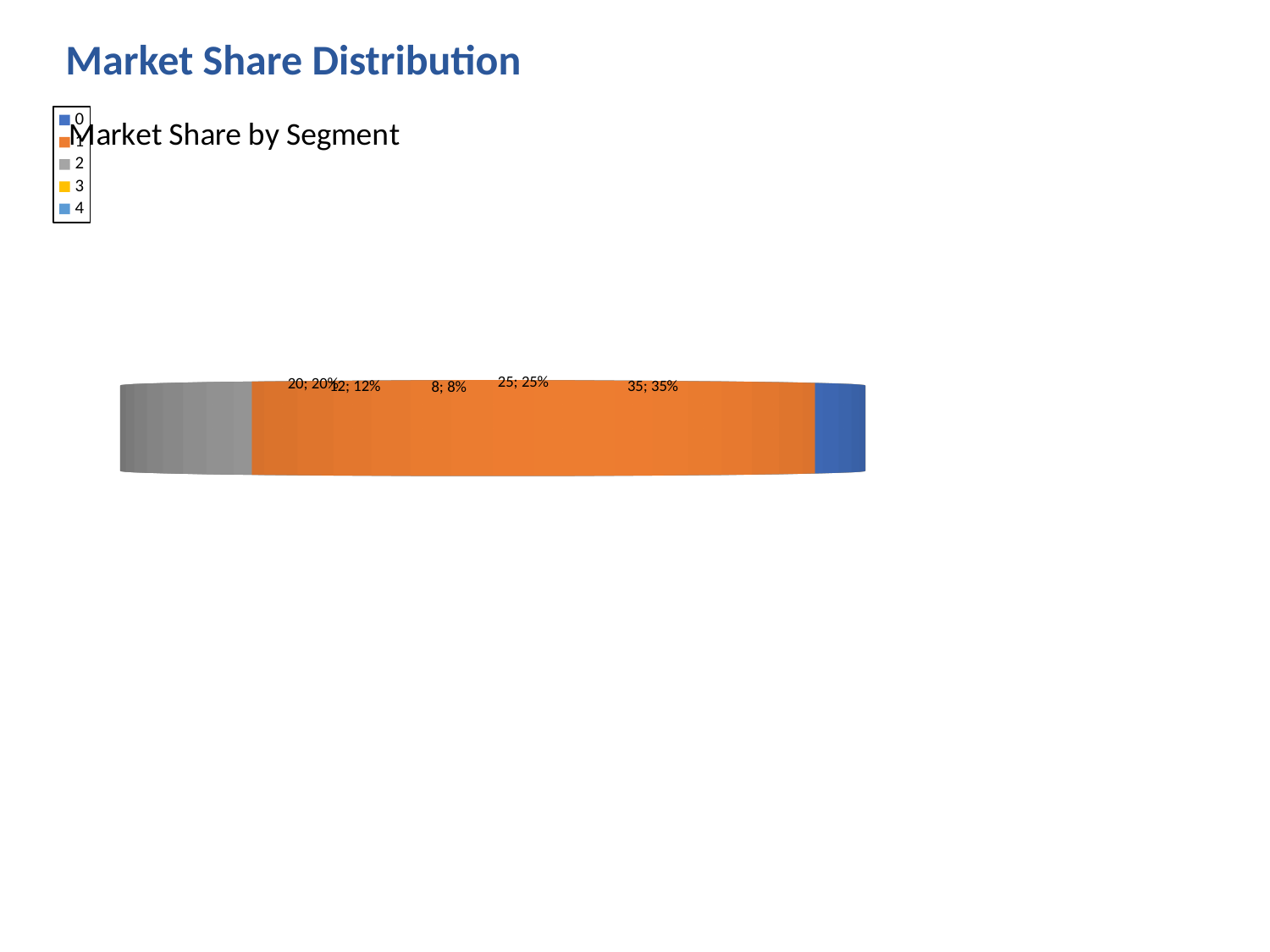
What is the smallest percentage shown in the chart's data labels? 8% What are the legend entries listed on the chart? 0, 1, 2, 3, 4 What kind of chart is shown on the slide? pie chart How many entries does the chart's legend list? 5 Is the largest value shown in the data labels greater or less than 30? greater What do the values shown in the chart's data labels add up to? 100 What is the title of the chart? Market Share by Segment What share of the pie does the slice labelled 12 represent? 12% What is the difference between the largest and smallest values shown in the data labels? 27 How many data labels are shown on the chart? 5 Which is larger, the slice labelled 25% or the slice labelled 20%? 25% What is the largest percentage shown in the chart's data labels? 35%